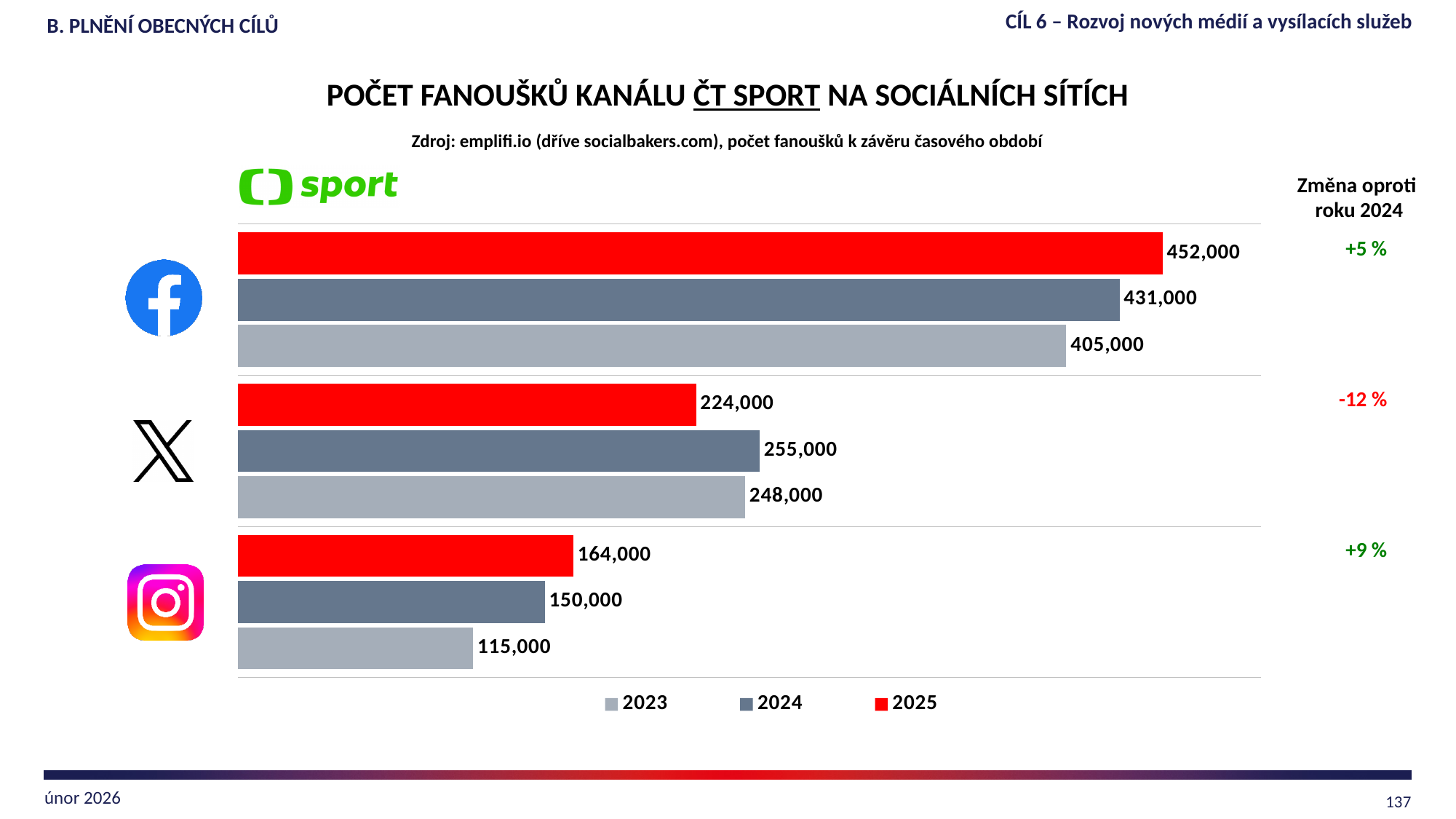
Which social network has the highest number of ČT sport fans in 2025? Facebook What is the number of ČT sport fans on Facebook in 2025? 452,000 What is the number of ČT sport fans on Instagram in 2023? 115,000 What is the number of ČT sport fans on X in 2024? 255,000 Did the number of ČT sport fans on X rise or fall from 2024 to 2025? Fall Which is larger: the Instagram fan count in 2025 or the Instagram fan count in 2024? 2025 What is the difference between the X fan counts in 2024 and 2025? 31,000 What kind of chart is shown on the slide? Bar chart What percentage change compared to 2024 is shown for Instagram? +9 % Which social network has the lowest number of ČT sport fans in 2023? Instagram What is the difference between the Facebook fan counts in 2025 and 2024? 21,000 How many series does the legend list? 3